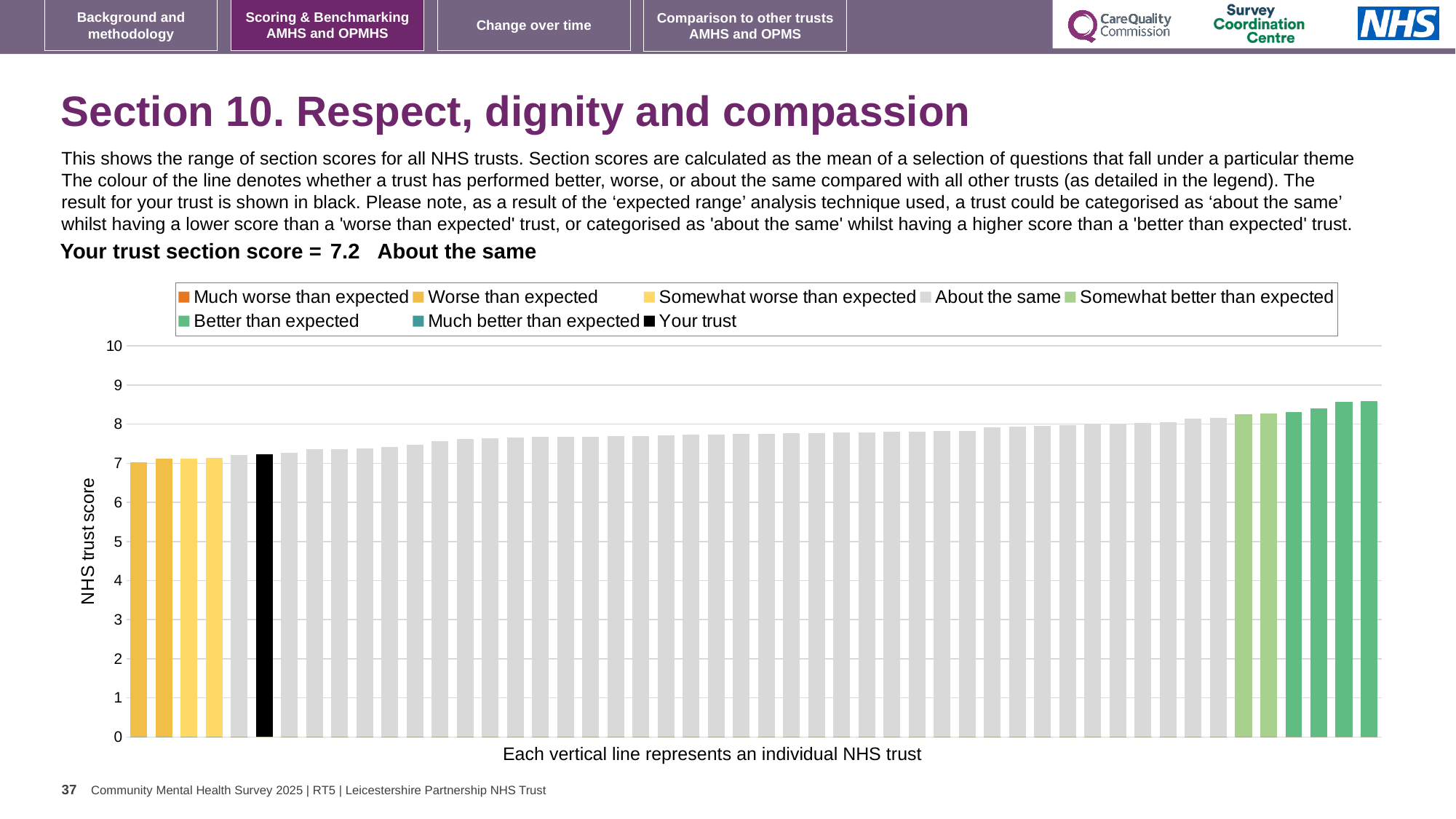
How many bars are coloured as 'Better than expected'? 4 Is the value for the highest bar greater or less than 9? less Is the value for the lowest bar greater or less than 6? greater Which category is your trust placed in for this section? About the same Which is larger, the leftmost bar or the rightmost bar? the rightmost bar Which legend category does the highest-scoring trust fall into? Better than expected What kind of chart is shown on the slide? bar chart Do the bar values rise or fall from left to right along the x axis? rise How many entries does the chart legend list? 8 What is the label on the vertical axis of the chart? NHS trust score Is the value for the black 'Your trust' bar greater or less than 8? less What is the section score for your trust? 7.2